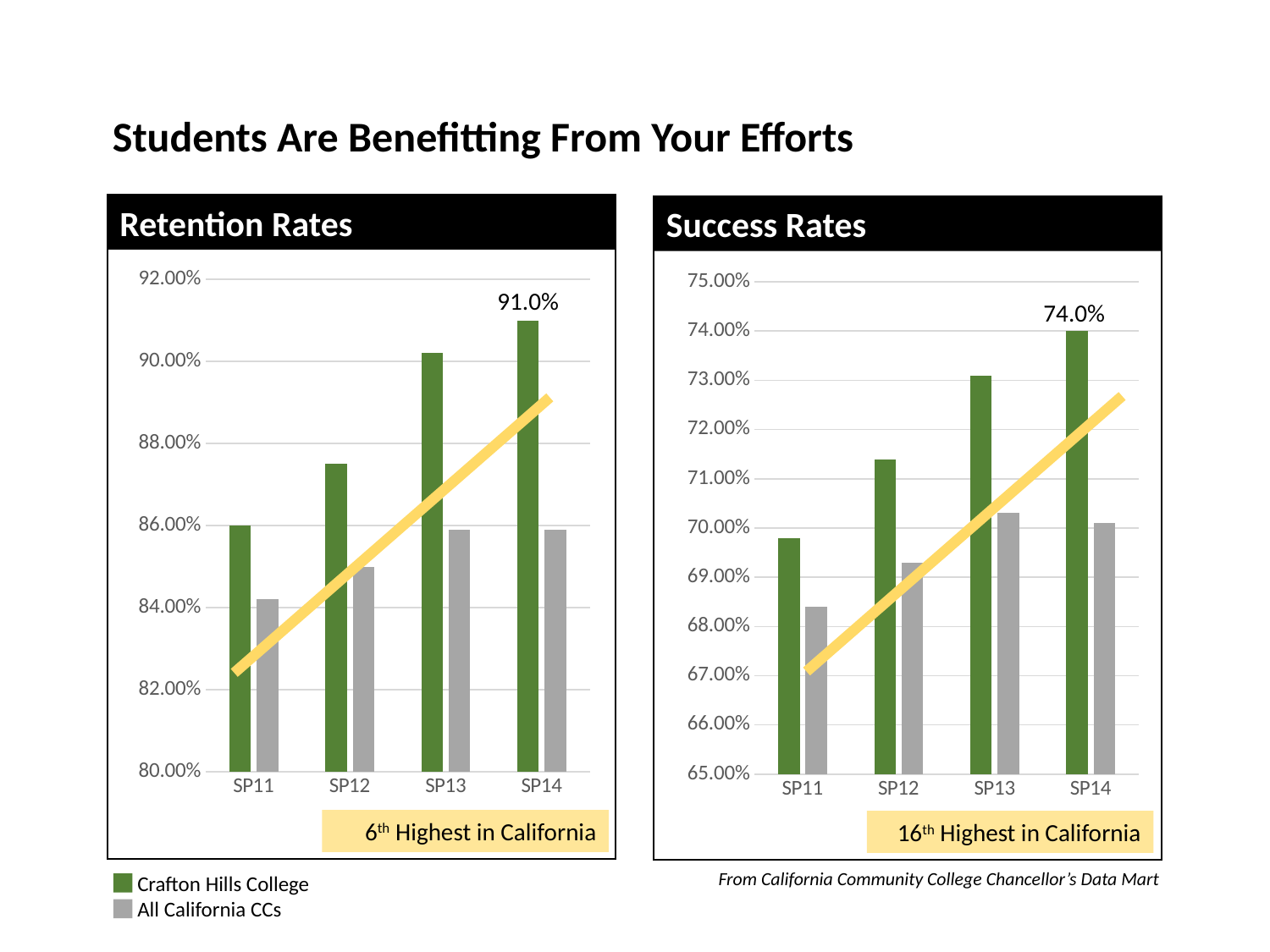
How many series does the legend list for the charts? 2 In the Retention Rates chart, do the Crafton Hills College values rise or fall from SP11 to SP14? Rise In the Retention Rates chart, which term has the highest Crafton Hills College value? SP14 How many terms are shown on the x axis of the Success Rates chart? 4 What kind of chart is the Retention Rates chart? Bar chart In the Success Rates chart, which term has the lowest Crafton Hills College value? SP11 What is the title of the chart on the right side of the slide? Success Rates In the Retention Rates chart, what is the value for Crafton Hills College in SP14? 91.0% In the Retention Rates chart, is the All California CCs value for SP11 greater or less than 86.00%? less In the Success Rates chart, what is the value for Crafton Hills College in SP14? 74.0% In the Success Rates chart, which is larger in SP13: Crafton Hills College or All California CCs? Crafton Hills College In the Success Rates chart, is the Crafton Hills College value for SP12 greater or less than 71.00%? greater